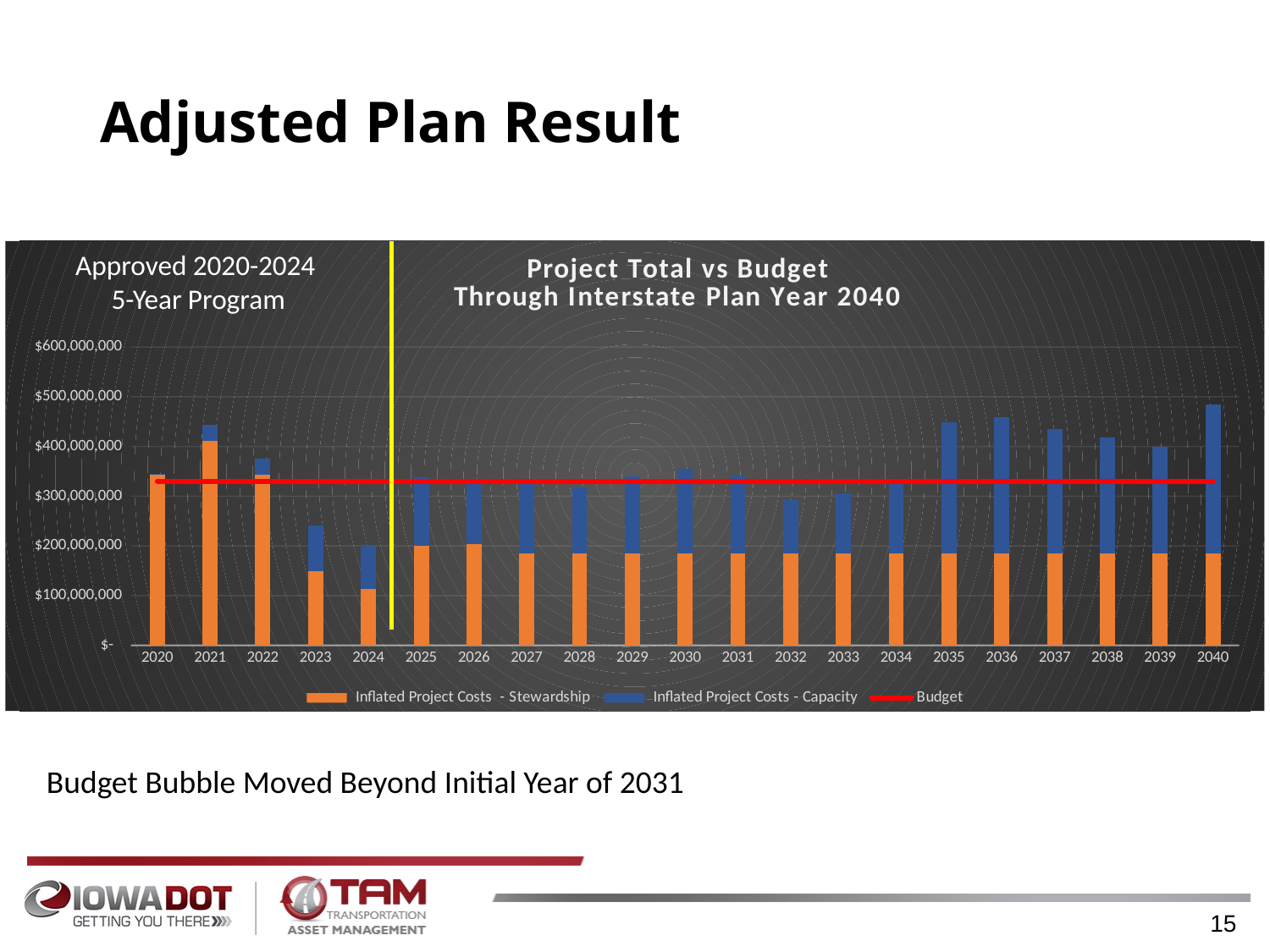
Does the Budget line rise, fall, or stay flat across the years? Stays flat Which year has the larger total bar, 2021 or 2022? 2021 Is the Inflated Project Costs - Stewardship value for 2023 greater or less than $200,000,000? less What is the title of the chart? Project Total vs Budget Through Interstate Plan Year 2040 What type of chart is shown on the slide? Stacked bar chart with a line How many years are shown along the x axis of the chart? 21 Which year has the tallest total bar in the chart? 2040 Which year has the shortest total bar in the chart? 2024 Is the total bar for 2035 greater or less than $400,000,000? greater Is the total bar for 2023 greater or less than $300,000,000? less How many series does the chart legend list? 3